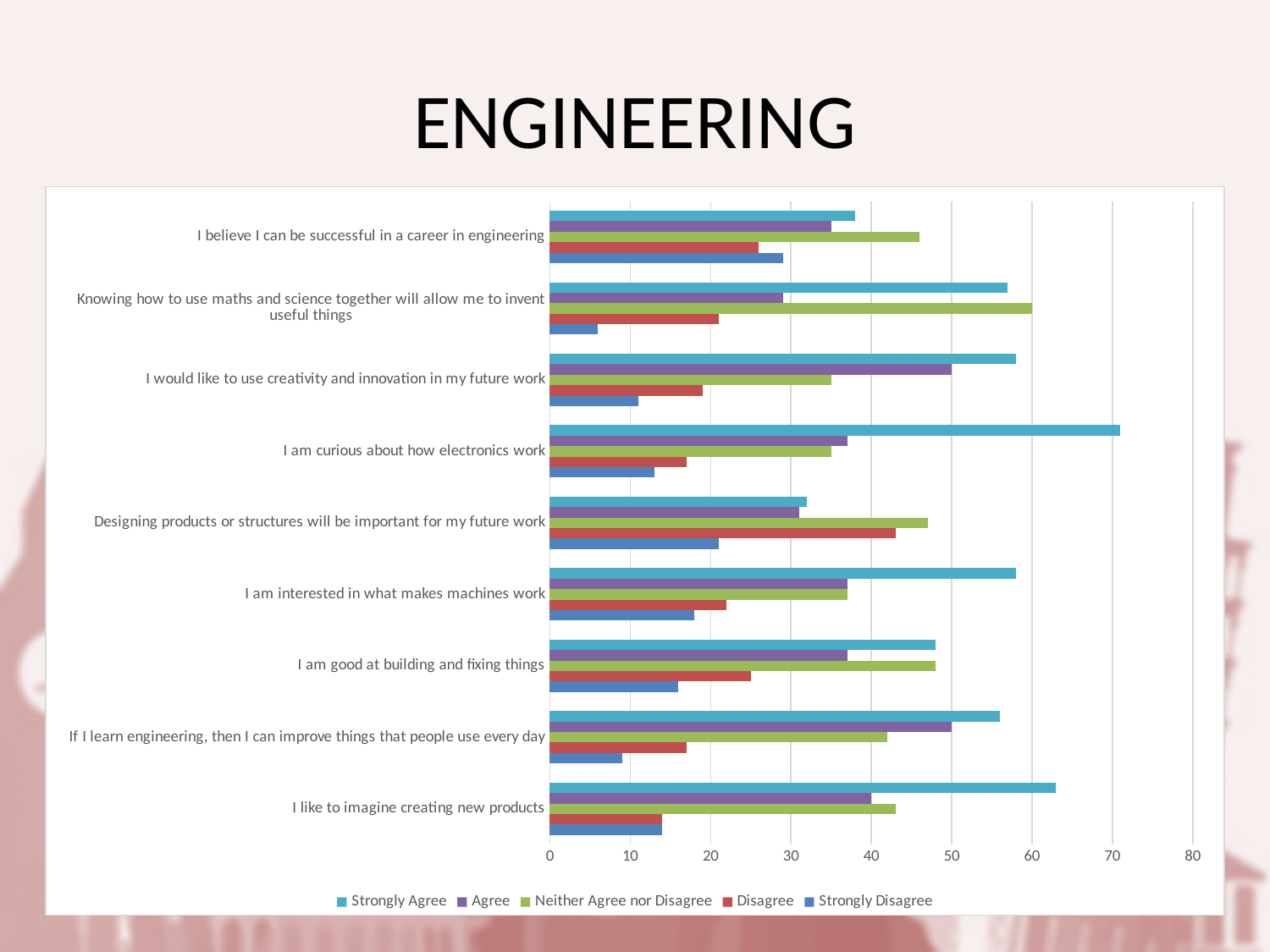
Which statement has the highest Strongly Agree value? I am curious about how electronics work Is the Strongly Agree value for 'I am curious about how electronics work' greater or less than 60? greater For 'I believe I can be successful in a career in engineering', which is larger: Strongly Agree or Neither Agree nor Disagree? Neither Agree nor Disagree Is the Strongly Agree value for 'I like to imagine creating new products' greater or less than 60? greater Is the Neither Agree nor Disagree value for 'Knowing how to use maths and science together will allow me to invent useful things' greater or less than 50? greater For 'Designing products or structures will be important for my future work', which is larger: Agree or Disagree? Disagree What kind of chart is shown on the slide? bar chart Which statement has the lowest Strongly Disagree value? Knowing how to use maths and science together will allow me to invent useful things How many series does the legend list? 5 How many statements (categories) are listed on the chart? 9 What is the title of the slide containing the chart? ENGINEERING